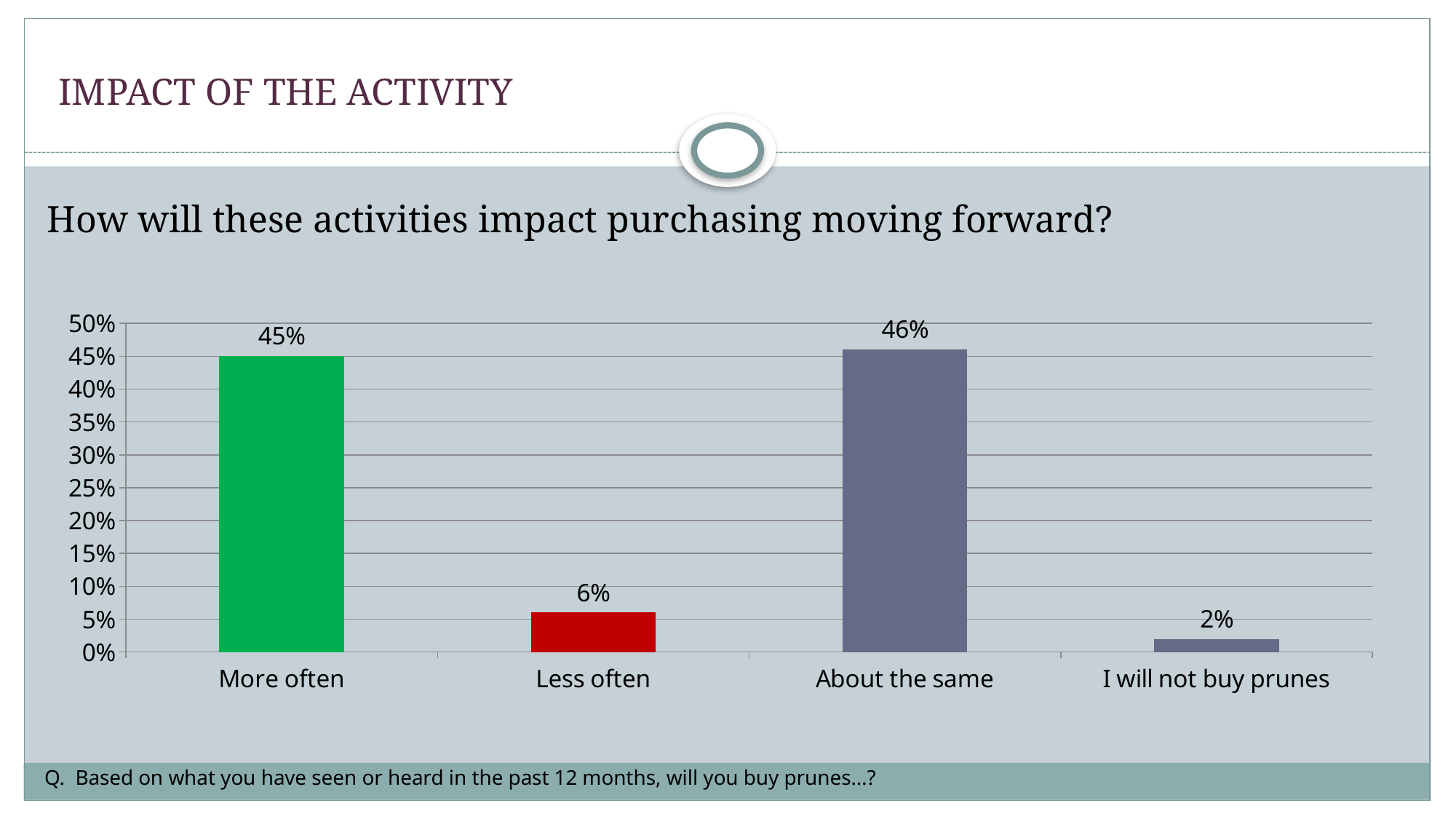
Which is larger, the value for 'Less often' or the value for 'I will not buy prunes'? Less often What colour is the bar for 'Less often'? Red What is the value shown for 'I will not buy prunes'? 2% Which category has the highest value? About the same What is the value shown for 'Less often'? 6% What percentage of respondents said they will buy prunes more often? 45% Which category has the lowest value? I will not buy prunes What is the difference between 'More often' and 'Less often'? 39% Is the value for 'More often' greater or less than 40%? greater What kind of chart is shown on the slide? Bar chart How many categories are shown on the x axis? 4 What is the difference between 'Less often' and 'I will not buy prunes'? 4%